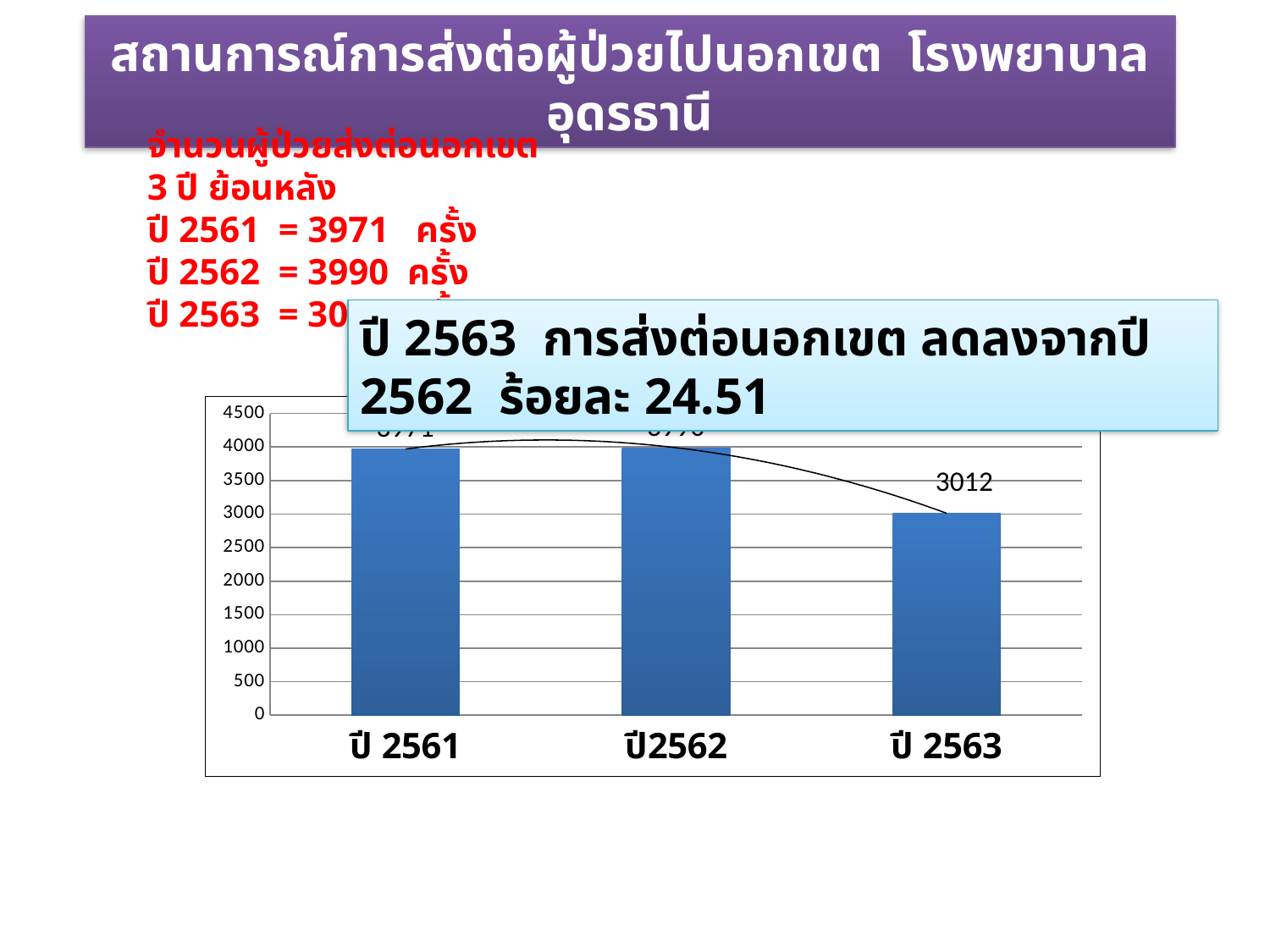
What is the value for ปี 2563 in the bar chart? 3012 What is the difference between the values for ปี 2561 and ปี 2563? 959 Which year has the highest value in the bar chart? ปี2562 What kind of chart is shown on the slide? bar chart What is the value for ปี2562 in the bar chart? 3990 Does the value rise or fall from ปี2562 to ปี 2563? fall Which year has the lowest value in the bar chart? ปี 2563 What is the value for ปี 2561 in the bar chart? 3971 How many years (categories) are shown in the bar chart? 3 What is the difference between the values for ปี2562 and ปี 2563? 978 Is the value for ปี 2563 greater or less than 3500? less Which is larger, the value for ปี 2561 or the value for ปี 2563? ปี 2561